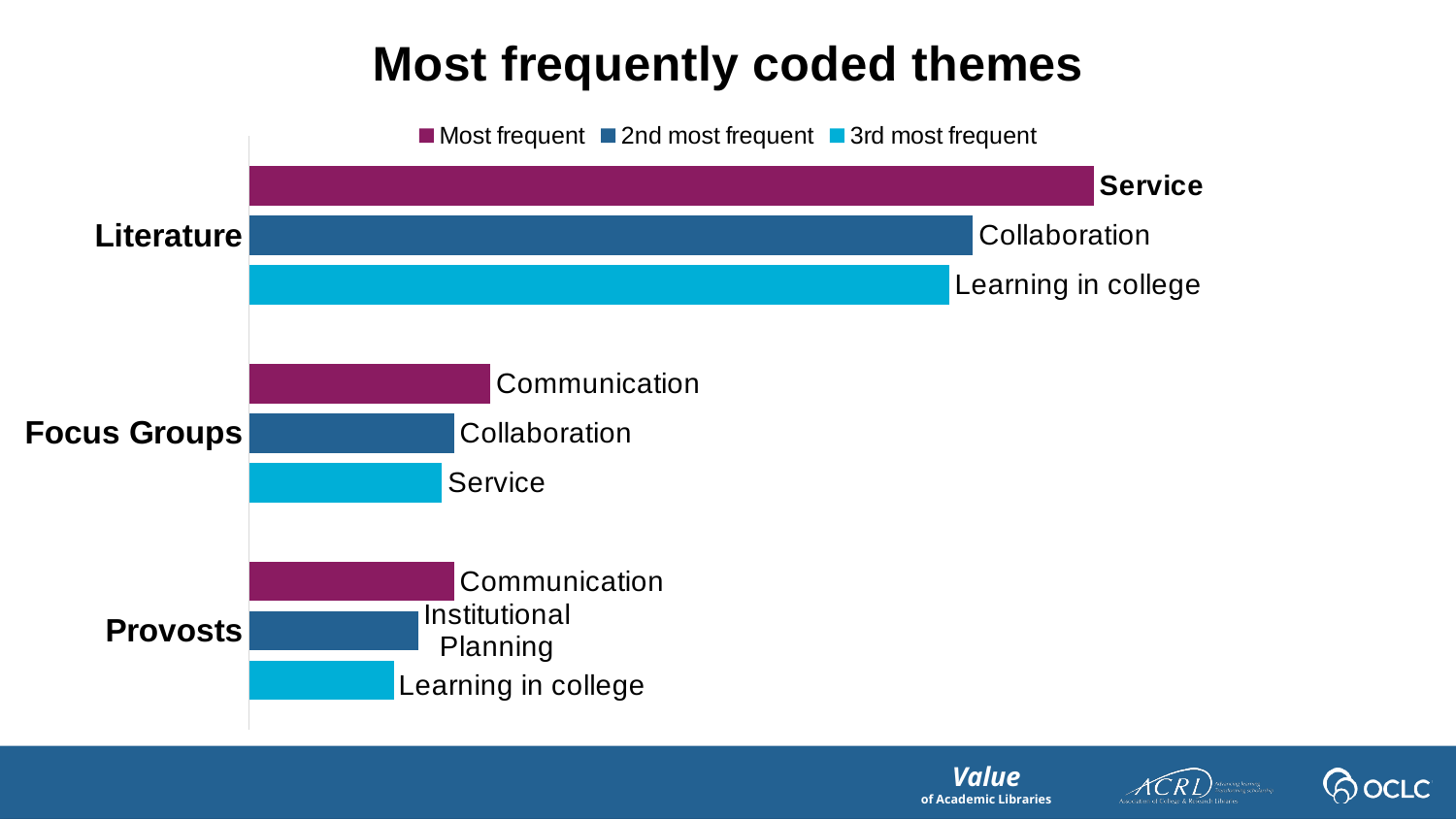
How many categories (groups) are shown on the vertical axis? 3 Is the most frequent bar for Focus Groups longer or shorter than the most frequent bar for Provosts? Longer Which theme is labeled as the most frequent for Literature? Service Which category has the shortest 3rd most frequent bar? Provosts Which theme is labeled as the 2nd most frequent for Provosts? Institutional Planning What is the title of the chart? Most frequently coded themes Which category has the longest bar overall? Literature What kind of chart is shown on the slide? Bar chart Which theme is labeled as the most frequent for Focus Groups? Communication Which theme is labeled as the 3rd most frequent for Focus Groups? Service How many series does the legend list? 3 Which theme is labeled as the 2nd most frequent for Literature? Collaboration